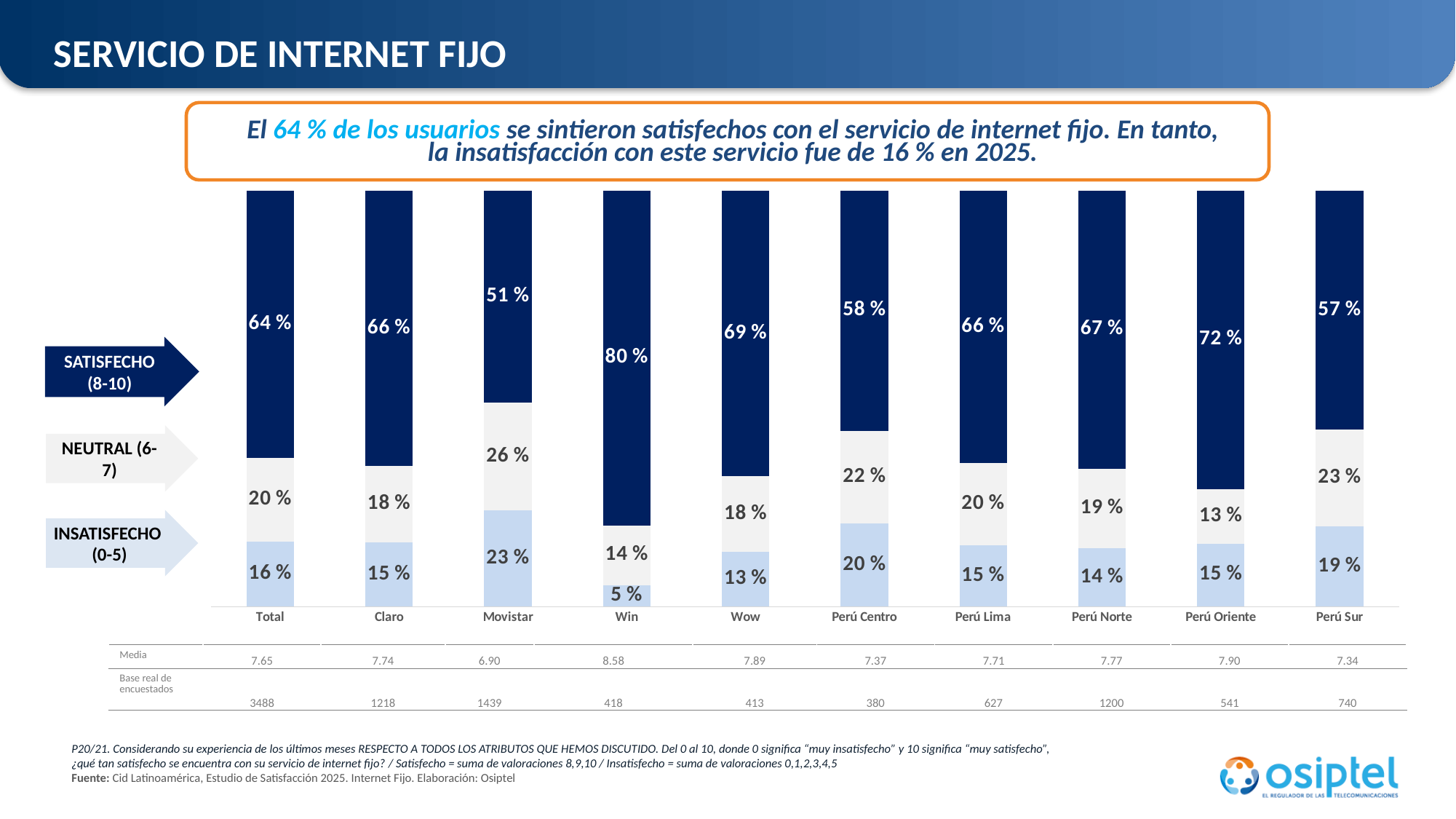
What is the Insatisfecho (0-5) percentage for Movistar? 23 % What is the Base real de encuestados for Total? 3488 Which has a higher Insatisfecho (0-5) percentage, Perú Centro or Perú Lima? Perú Centro Which category has the lowest Insatisfecho (0-5) percentage? Win How many series does the chart show? 3 What is the Neutral (6-7) percentage for Perú Sur? 23 % What kind of chart is shown on the slide? Stacked bar chart Which category has the highest Satisfecho (8-10) percentage? Win How many categories are shown on the x axis of the chart? 10 What is the difference between the Satisfecho (8-10) percentages for Perú Oriente and Perú Sur? 15 % What is the Media value shown for Movistar? 6.90 What is the Satisfecho (8-10) percentage for Win? 80 %